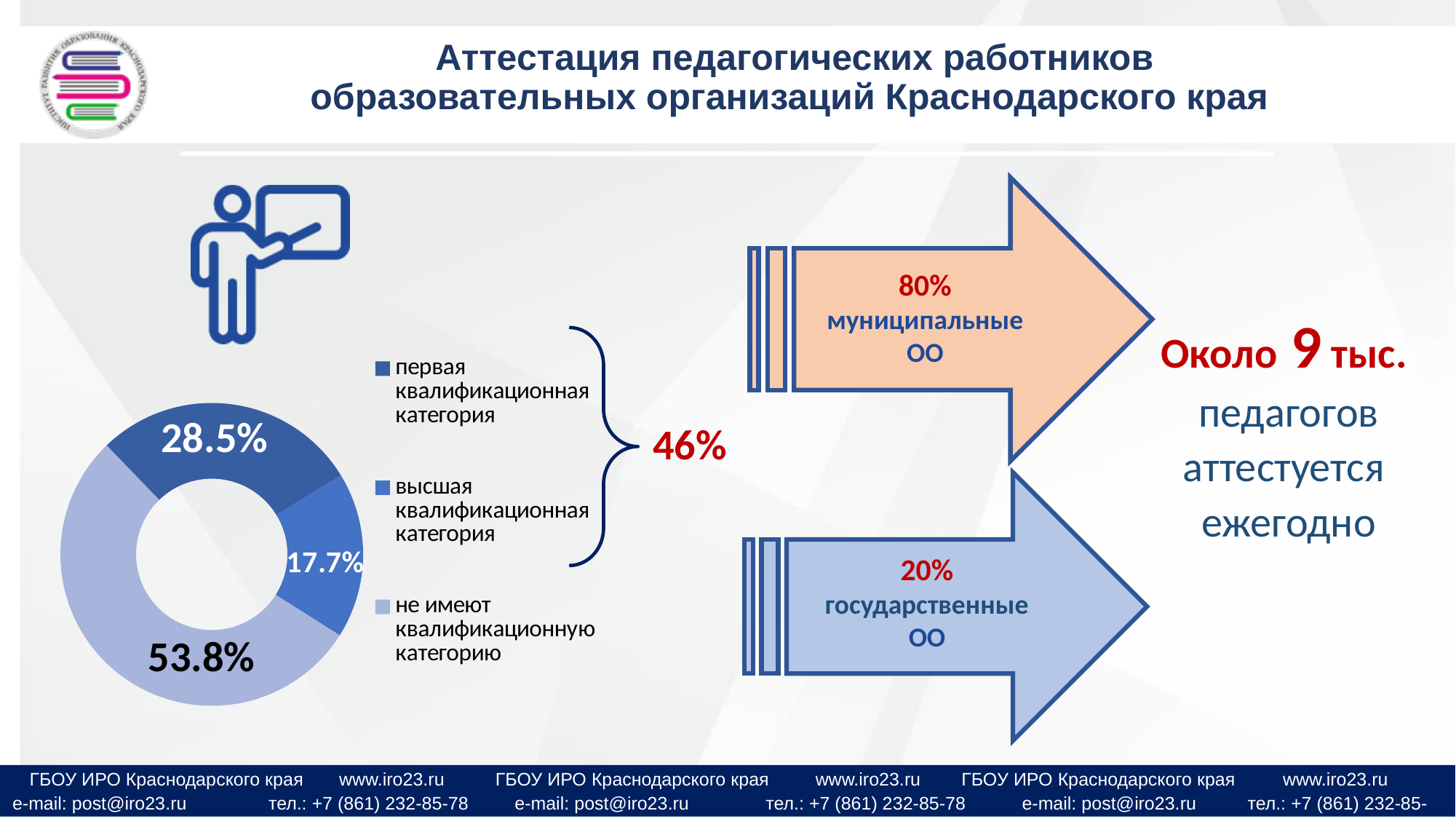
How many categories does the donut chart show? 3 Which is larger: the share with the first qualification category or the share with the highest qualification category? первая квалификационная категория Which category has the smallest slice in the donut chart? высшая квалификационная категория What kind of chart is shown on the left of the slide? Pie (donut) chart Which category has the largest slice in the donut chart? не имеют квалификационную категорию What is the difference between the first qualification category share and the highest qualification category share? 10.8% What share of teachers have the first qualification category (первая квалификационная категория)? 28.5% Which legend entry is shown in the lightest blue colour? не имеют квалификационную категорию What is the difference between the share without a qualification category and the share with the first qualification category? 25.3% Is the share of teachers without a qualification category greater or less than 50%? greater What share of teachers do not have a qualification category (не имеют квалификационную категорию)? 53.8% What share of teachers have the highest qualification category (высшая квалификационная категория)? 17.7%